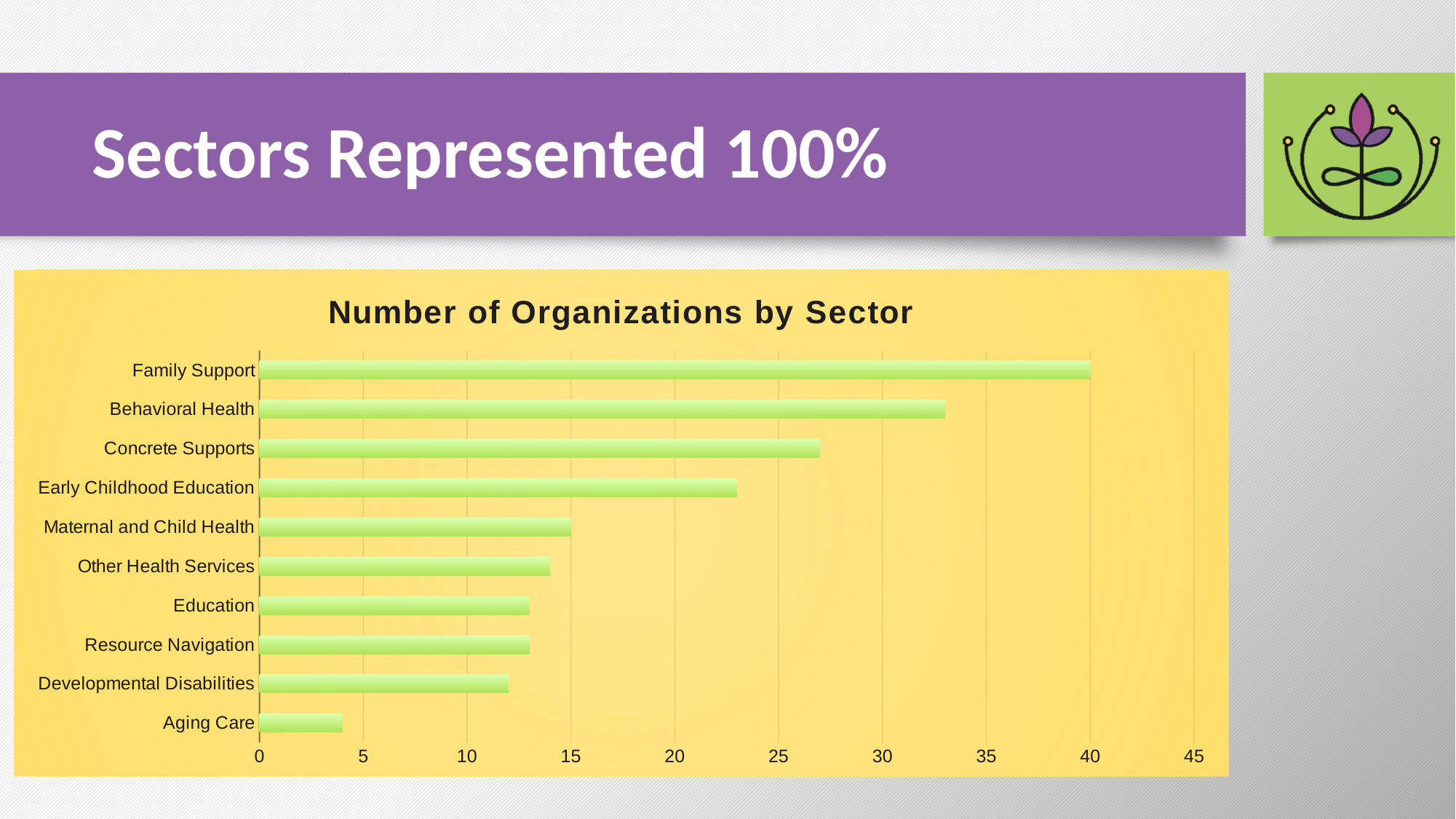
What type of chart is shown on the slide? Bar chart Which has more organizations, Behavioral Health or Early Childhood Education? Behavioral Health What is the number of organizations for Family Support? 40 Is the value for Aging Care greater or less than 5? less What is the title of the chart? Number of Organizations by Sector Which sector has the lowest number of organizations? Aging Care What is the number of organizations for Maternal and Child Health? 15 How many sectors are shown in the chart? 10 Is the value for Concrete Supports greater or less than 25? greater Is the value for Behavioral Health greater or less than 30? greater What colour are the bars in the chart? Green Which sector has the highest number of organizations? Family Support